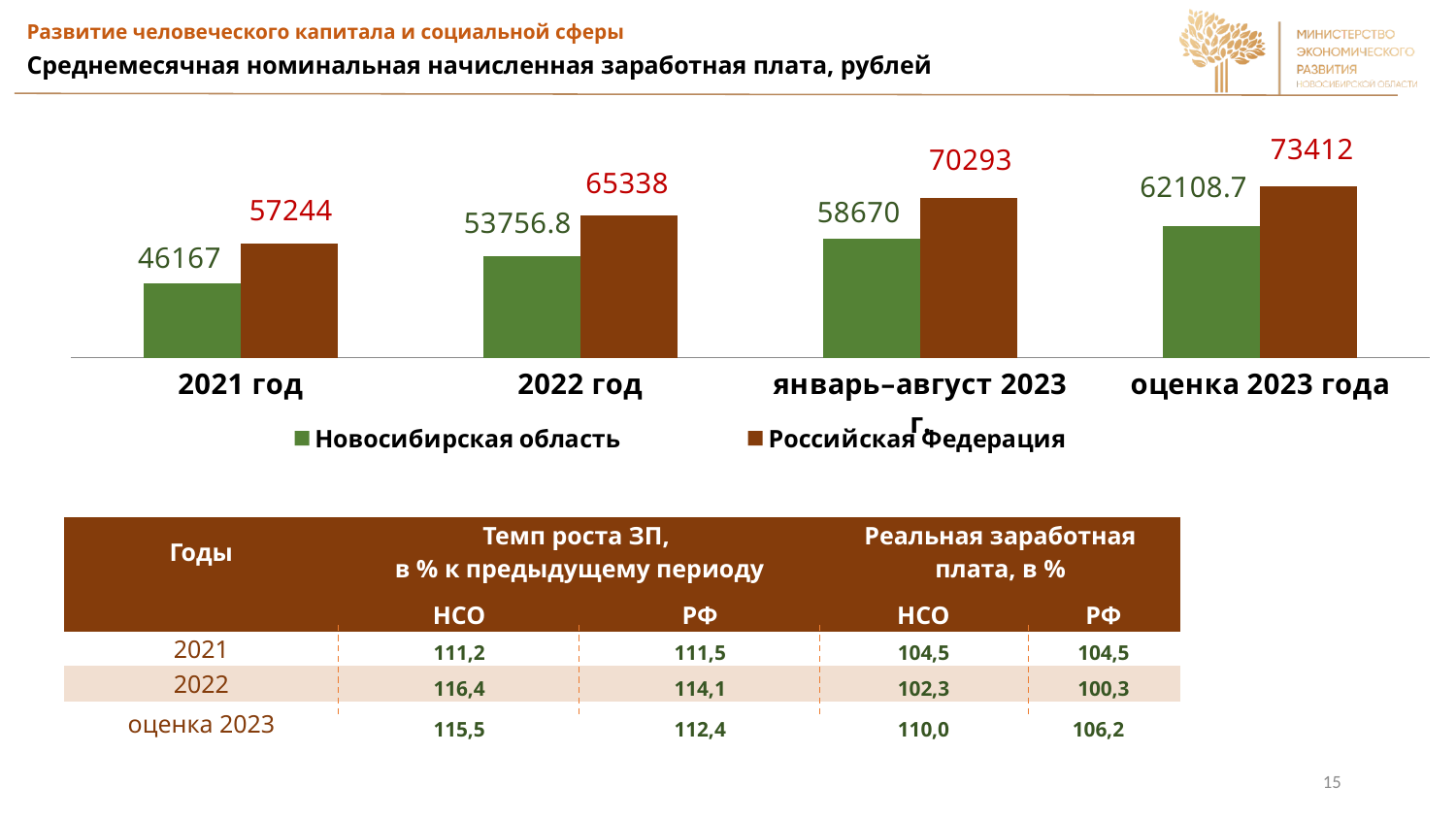
In which category is the value for Российская Федерация the highest? оценка 2023 года Do the values for Новосибирская область rise or fall from 2021 год to оценка 2023 года? rise What is the value for Российская Федерация in оценка 2023 года? 73412 What is the value for Новосибирская область in январь–август 2023 г.? 58670 What kind of chart is shown on the slide? bar chart What is the value for Новосибирская область in 2021 год? 46167 What is the value for Российская Федерация in 2022 год? 65338 In which category is the value for Новосибирская область the lowest? 2021 год How many categories are shown on the x axis of the chart? 4 What is the difference between Российская Федерация and Новосибирская область in 2021 год? 11077 How many series does the legend list? 2 Which is larger in 2022 год: Новосибирская область or Российская Федерация? Российская Федерация